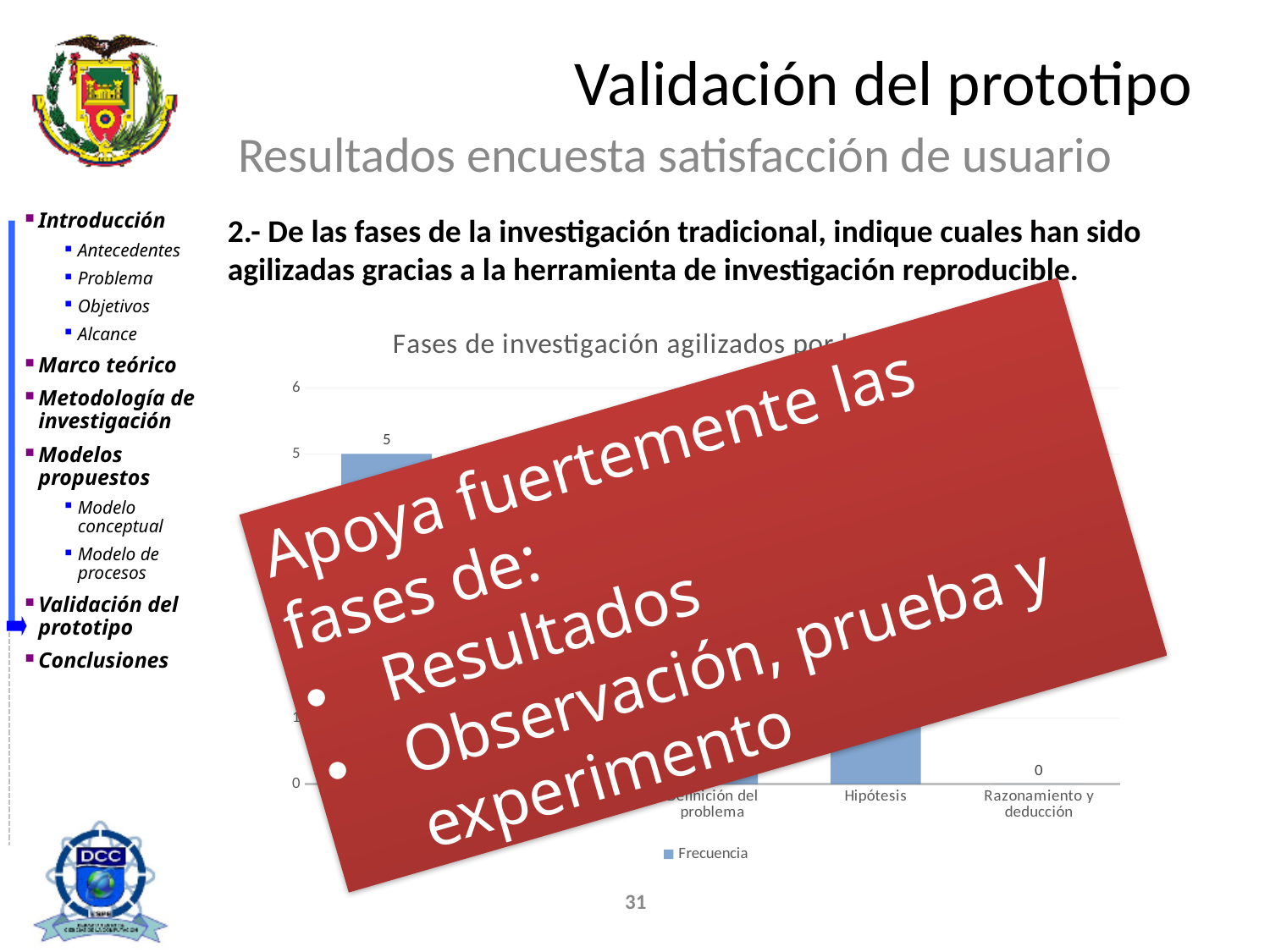
What series does the legend list? Frecuencia Is the value for Hipótesis greater or less than 2? less What is the value for Razonamiento y deducción? 0 Which is larger, the value for Hipótesis or the value for Razonamiento y deducción? Hipótesis How many series does the legend list? 1 What kind of chart is shown? bar chart What is the highest tick shown on the vertical axis? 6